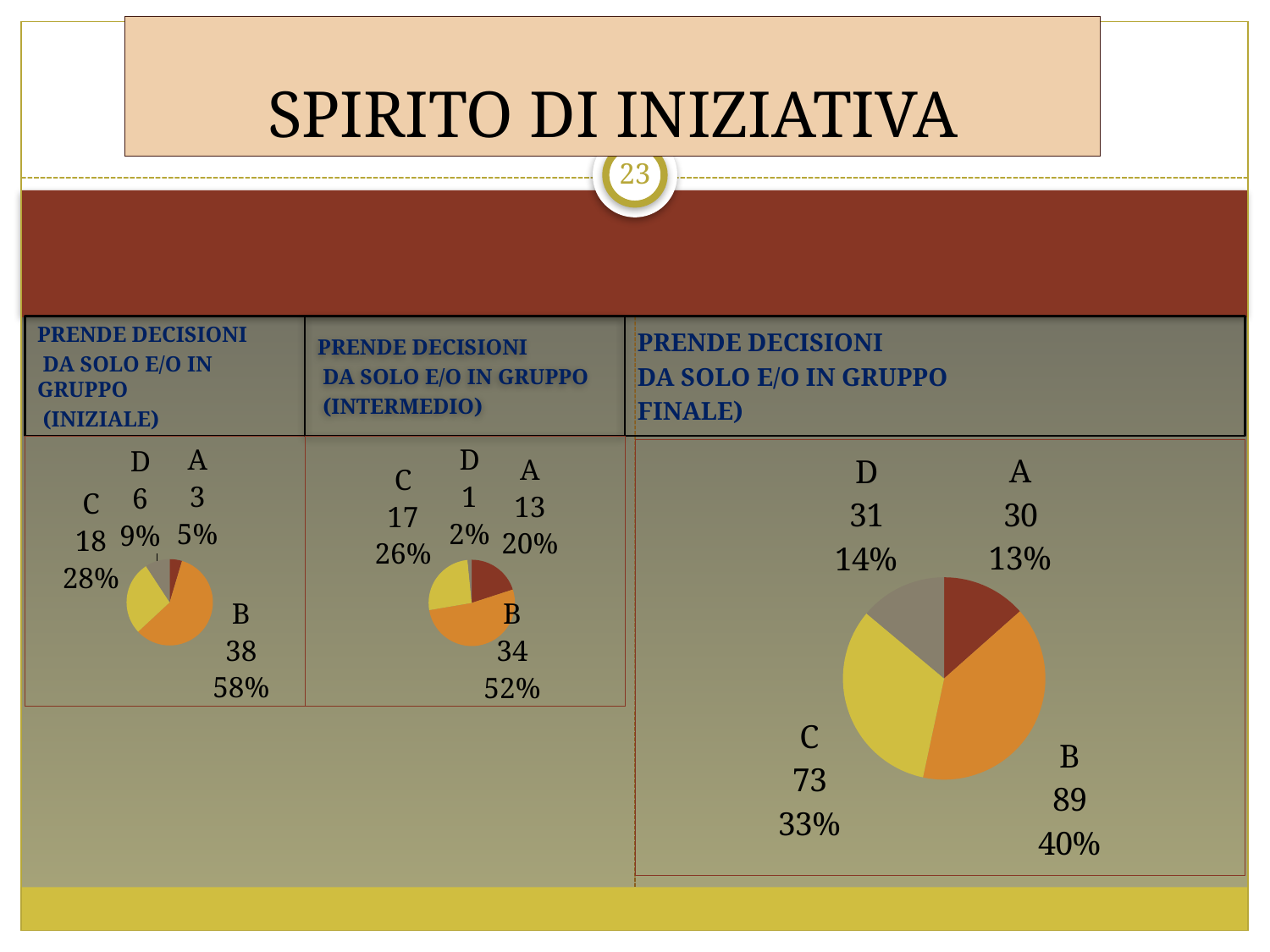
In the INTERMEDIO pie chart, what share of the pie does category D represent? 2% In the INTERMEDIO pie chart, what is the value for category C? 17 In the FINALE pie chart, what is the value for category B? 89 In the INIZIALE pie chart, which category has the smallest value? A How many categories does the FINALE pie chart show? 4 What type of chart is used on this slide? Pie chart In the INTERMEDIO pie chart, which category has the largest value? B In the FINALE pie chart, what share of the pie does category C represent? 33% In the INTERMEDIO pie chart, what is the difference between the values for B and C? 17 In the INIZIALE pie chart, what is the value for category B? 38 In the FINALE pie chart, which is larger, the value for A or the value for D? D In the INIZIALE pie chart, what share of the pie does category C represent? 28%